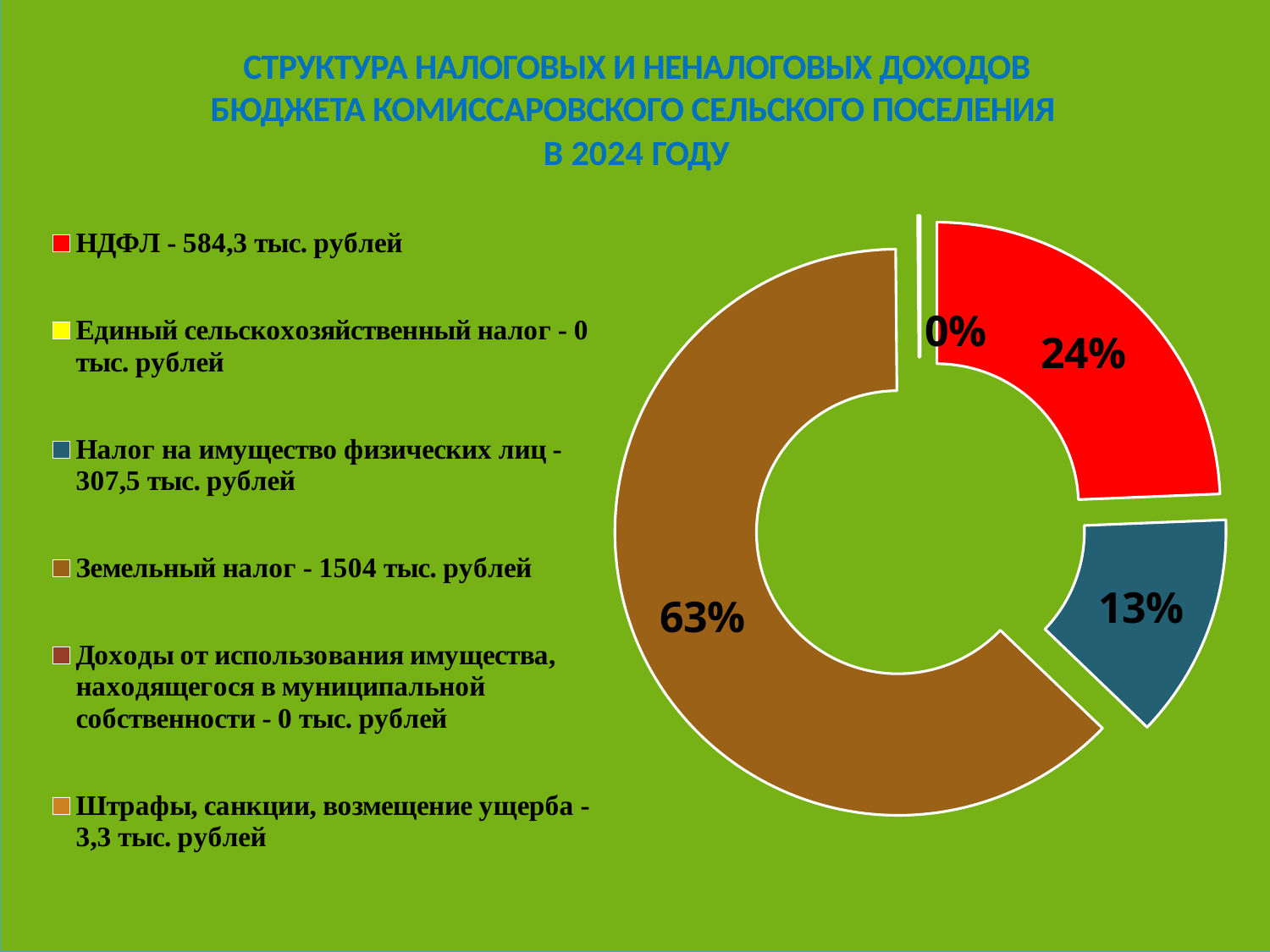
According to the legend, what is the value for НДФЛ? 584,3 тыс. рублей What colour is the slice for Налог на имущество физических лиц? Blue What kind of chart is shown on the slide? Doughnut chart What share of the chart does Налог на имущество физических лиц (the blue slice) represent? 13% According to the legend, what is the value for Земельный налог? 1504 тыс. рублей What share of the doughnut chart does НДФЛ (the red slice) represent? 24% Which category has the largest share of the chart? Земельный налог Which is larger, the share for НДФЛ or the share for Налог на имущество физических лиц? НДФЛ How many categories does the legend list? 6 What share of the chart does Земельный налог (the brown slice) represent? 63% According to the legend, what is the value for Штрафы, санкции, возмещение ущерба? 3,3 тыс. рублей What is the difference in percentage points between the Земельный налог share and the НДФЛ share? 39